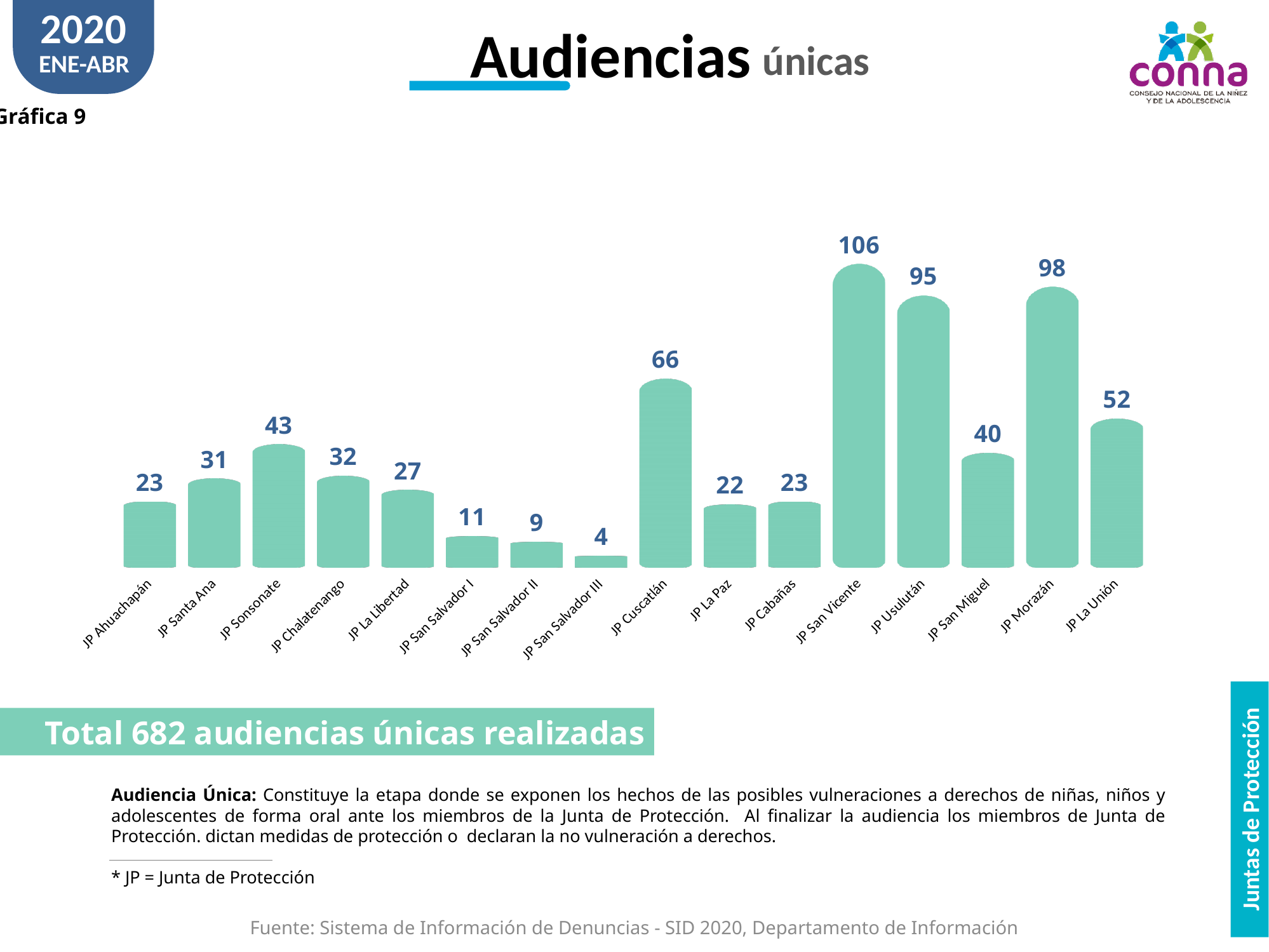
Which category has the highest value? JP San Vicente What kind of chart is shown on the slide? Bar chart What is the value for JP Cuscatlán? 66 How many categories are shown on the chart? 16 Which category has the lowest value? JP San Salvador III What is the difference between the values for JP La Unión and JP San Miguel? 12 What is the value for JP San Salvador III? 4 What total number of audiencias únicas does the slide state? 682 What is the difference between the values for JP Morazán and JP Usulután? 3 Which is larger, the value for JP Sonsonate or the value for JP Chalatenango? JP Sonsonate What is the value for JP San Vicente? 106 What is the value for JP La Paz? 22